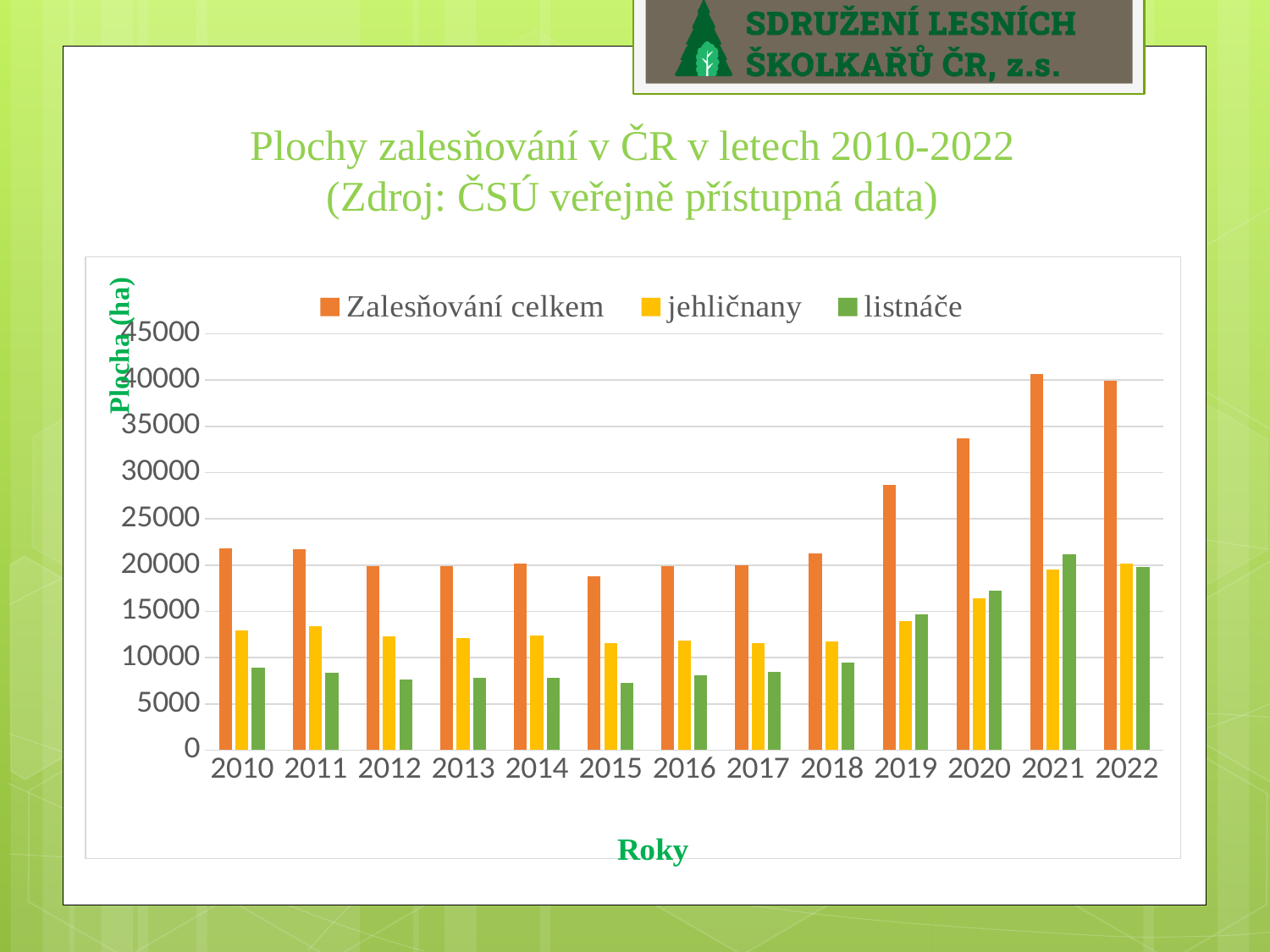
Which is larger in 2021, the value for jehličnany or the value for listnáče? listnáče What kind of chart is shown on the slide? bar chart In which year is the value for Zalesňování celkem lowest? 2015 Is the value for listnáče in 2010 greater or less than 10000? less Is the value for Zalesňování celkem in 2021 greater or less than 40000? greater What is the label of the x axis? Roky In which year is the value for listnáče highest? 2021 How many years are shown on the x axis? 13 Is the value for jehličnany in 2020 greater or less than 15000? greater How many series does the legend list? 3 In which year is the value for Zalesňování celkem highest? 2021 Does the value for Zalesňování celkem rise or fall from 2018 to 2021? rise